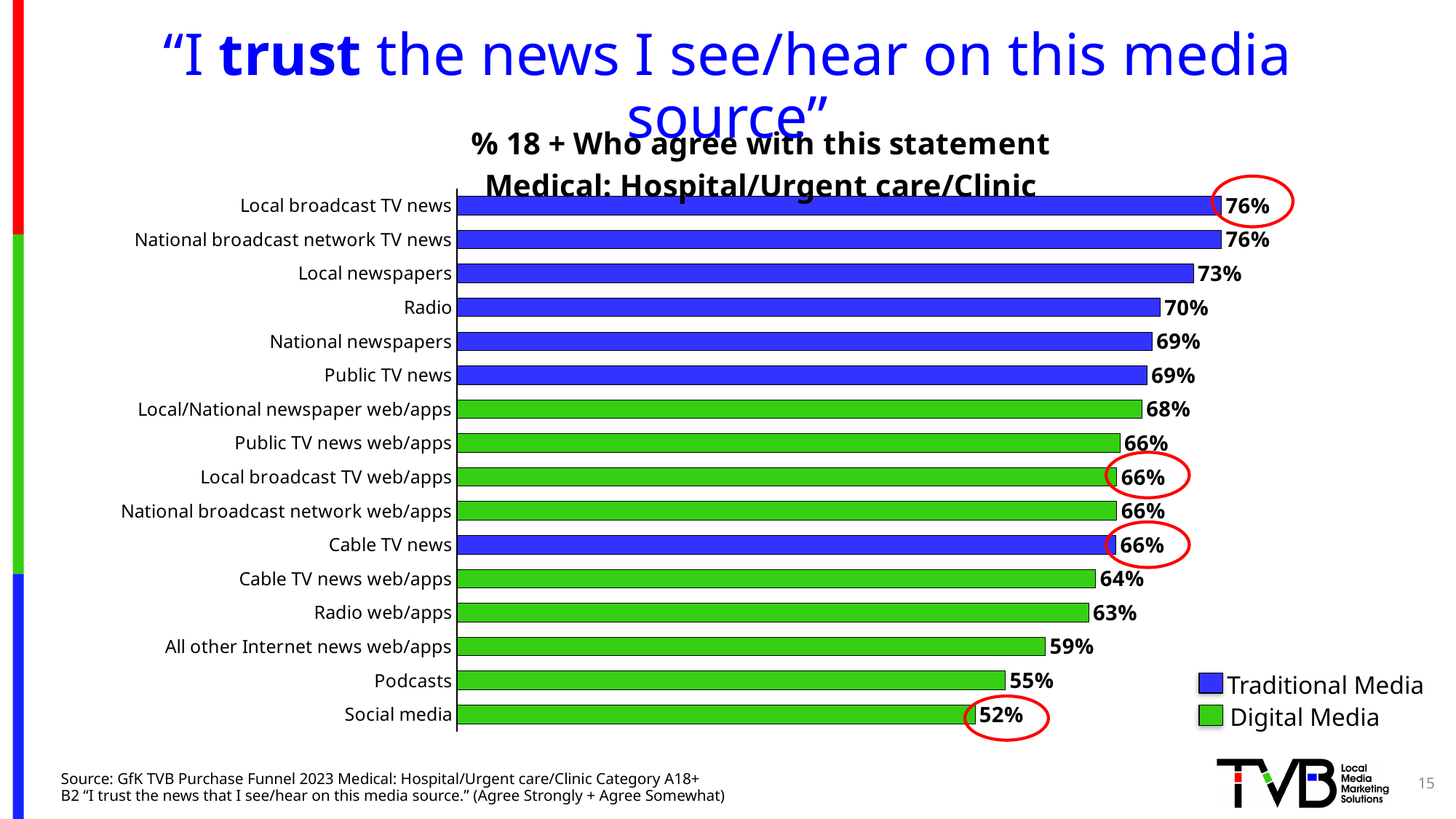
How many series does the legend list? 2 Which legend entry is represented by the green bars? Digital Media What is the difference between the values for Local broadcast TV news and Social media? 24% Which media source has the lowest percentage of agreement? Social media What percentage of adults 18+ agree they trust the news on Local newspapers? 73% What is the value shown for Radio web/apps? 63% What kind of chart is shown on the slide? Bar chart What is the value shown for Public TV news web/apps? 66% Which has a higher value, Cable TV news web/apps or All other Internet news web/apps? Cable TV news web/apps How many media sources (categories) are shown in the chart? 16 What is the value shown for Social media? 52% What is the difference between the values for Radio and Podcasts? 15%